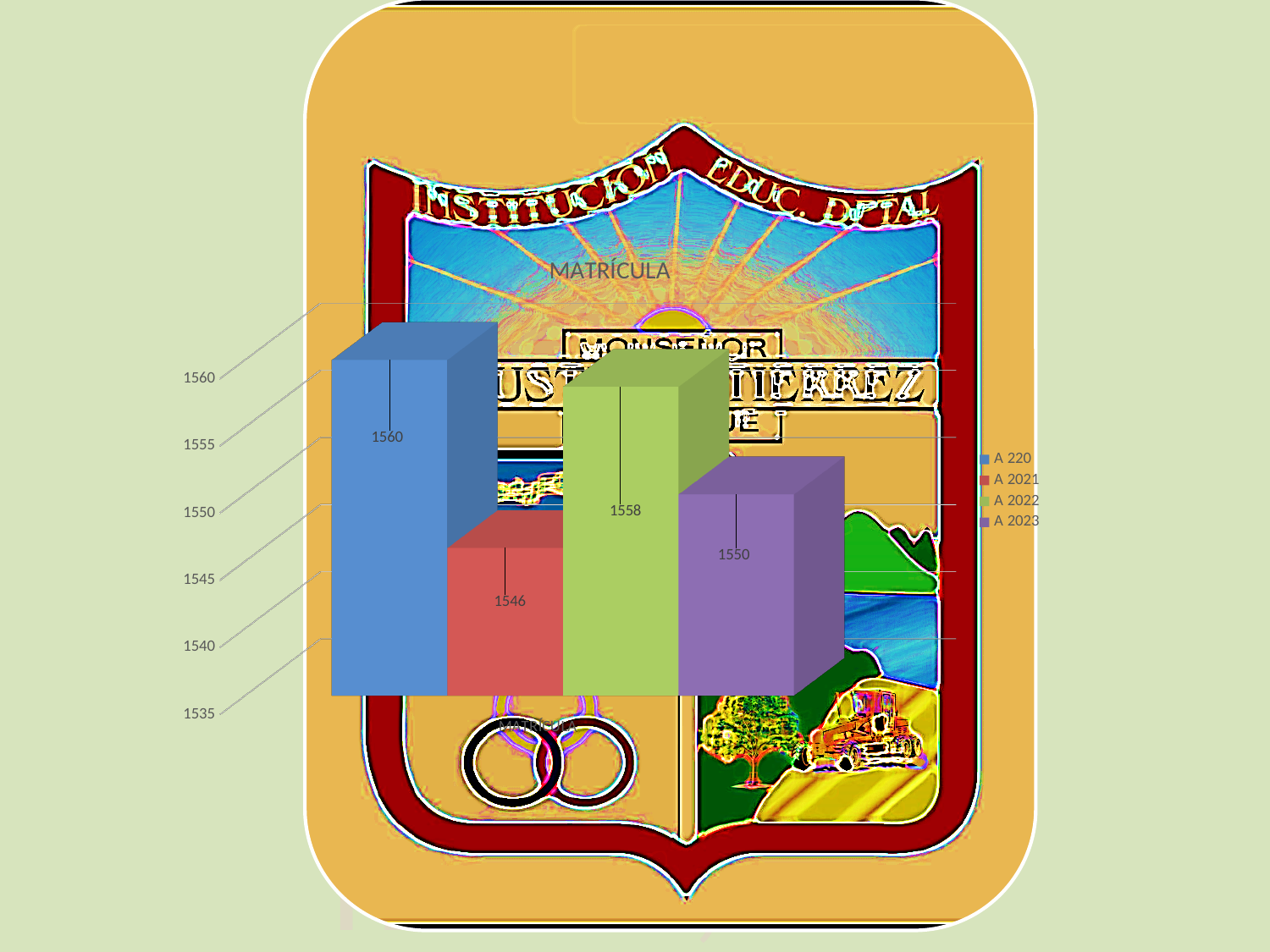
What is the value for A 2021? 1546 What is the difference between the values for A 220 and A 2021? 14 Which is larger, the value for A 2022 or the value for A 2023? A 2022 What is the title of the chart? MATRÍCULA What type of chart is shown on the slide? bar chart Which legend entry has the lowest value? A 2021 What is the value for A 220? 1560 How many entries does the legend list? 4 What is the value for A 2023? 1550 Which legend entry has the highest value? A 220 Is the value for A 2023 greater or less than 1545? greater What is the value for A 2022? 1558